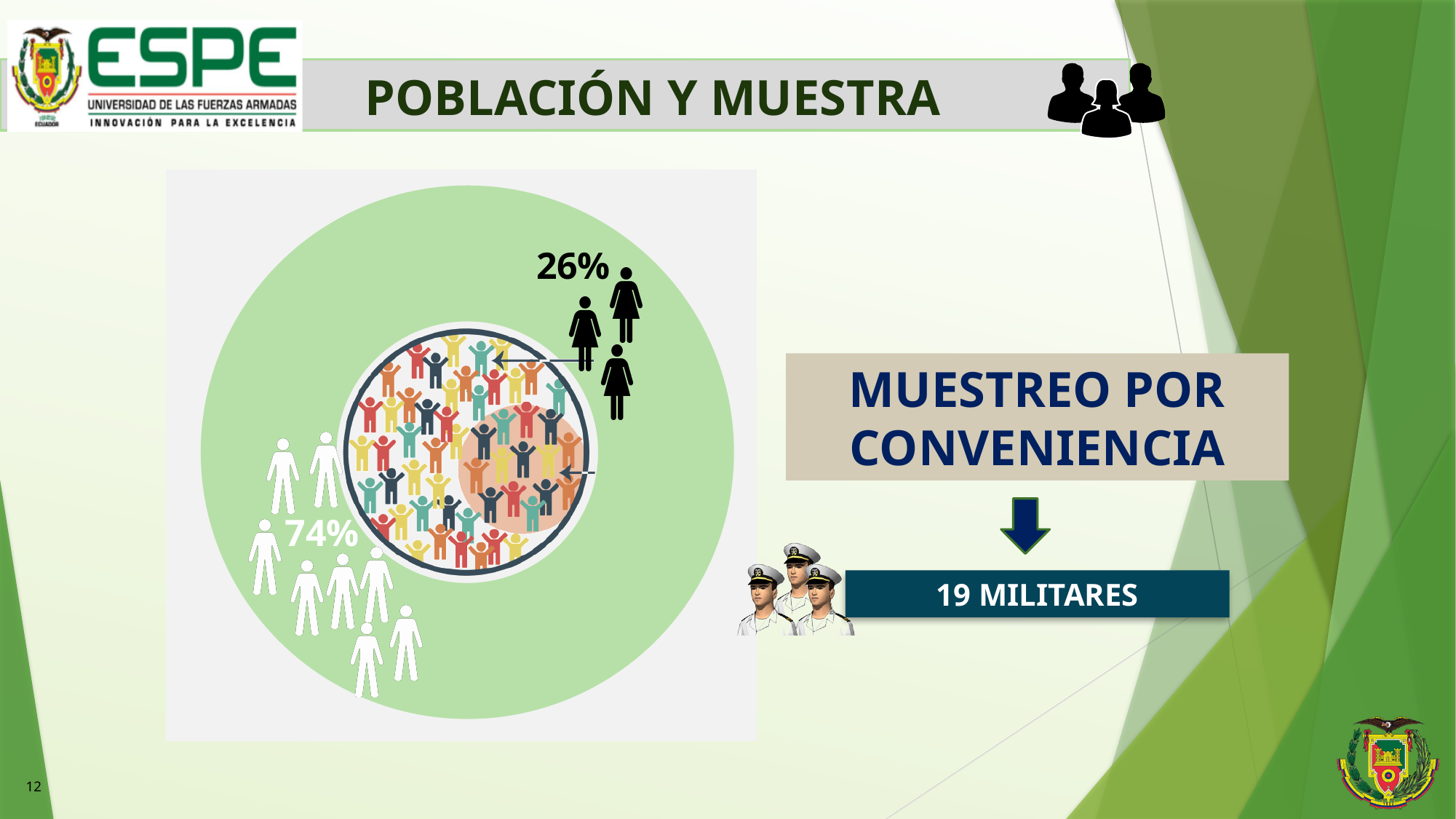
Is the percentage next to the black figures greater or less than 50%? less What percentage is printed next to the white human figures in the circular graphic? 74% What is the title of the slide containing the circular population graphic? POBLACIÓN Y MUESTRA What sample size is stated in the dark blue box on the right of the slide? 19 MILITARES How many percentage values are printed in the circular graphic? 2 Is the percentage next to the white figures greater or less than 50%? greater What do the two percentages shown in the circular graphic (26% and 74%) add up to? 100% Which percentage in the circular graphic is larger, the one by the black figures or the one by the white figures? 74% (white figures) What is the difference between the two percentages shown in the circular graphic (74% and 26%)? 48% What percentage is printed next to the black human figures in the circular graphic? 26%